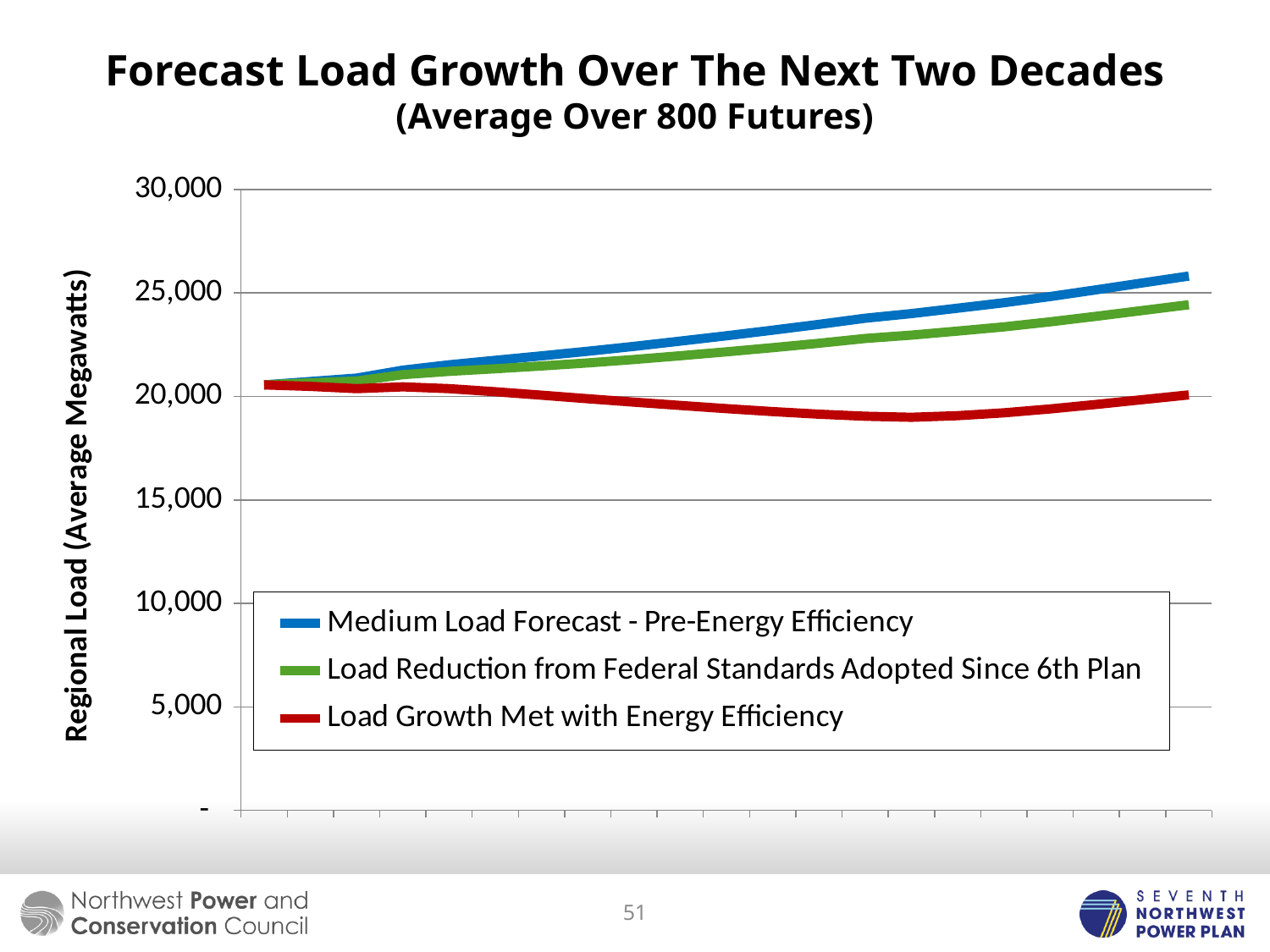
Is the value of the Medium Load Forecast - Pre-Energy Efficiency line at the right end of the chart greater or less than 25,000? greater What kind of chart is shown on the slide? Line chart Does the Load Reduction from Federal Standards Adopted Since 6th Plan line rise or fall from left to right? Rises What is the title of the vertical axis? Regional Load (Average Megawatts) Which series has the highest value at the right end of the chart? Medium Load Forecast - Pre-Energy Efficiency Which series has the lowest value at the right end of the chart? Load Growth Met with Energy Efficiency What colour is the Load Growth Met with Energy Efficiency line? Red Does the Medium Load Forecast - Pre-Energy Efficiency line rise or fall from left to right? Rises At the right end of the chart, which is larger: the Load Reduction from Federal Standards Adopted Since 6th Plan line or the Load Growth Met with Energy Efficiency line? Load Reduction from Federal Standards Adopted Since 6th Plan Is the value of the Load Growth Met with Energy Efficiency line at the right end of the chart greater or less than 25,000? less Is the lowest point of the Load Growth Met with Energy Efficiency line greater or less than 20,000? less How many series does the legend list? 3